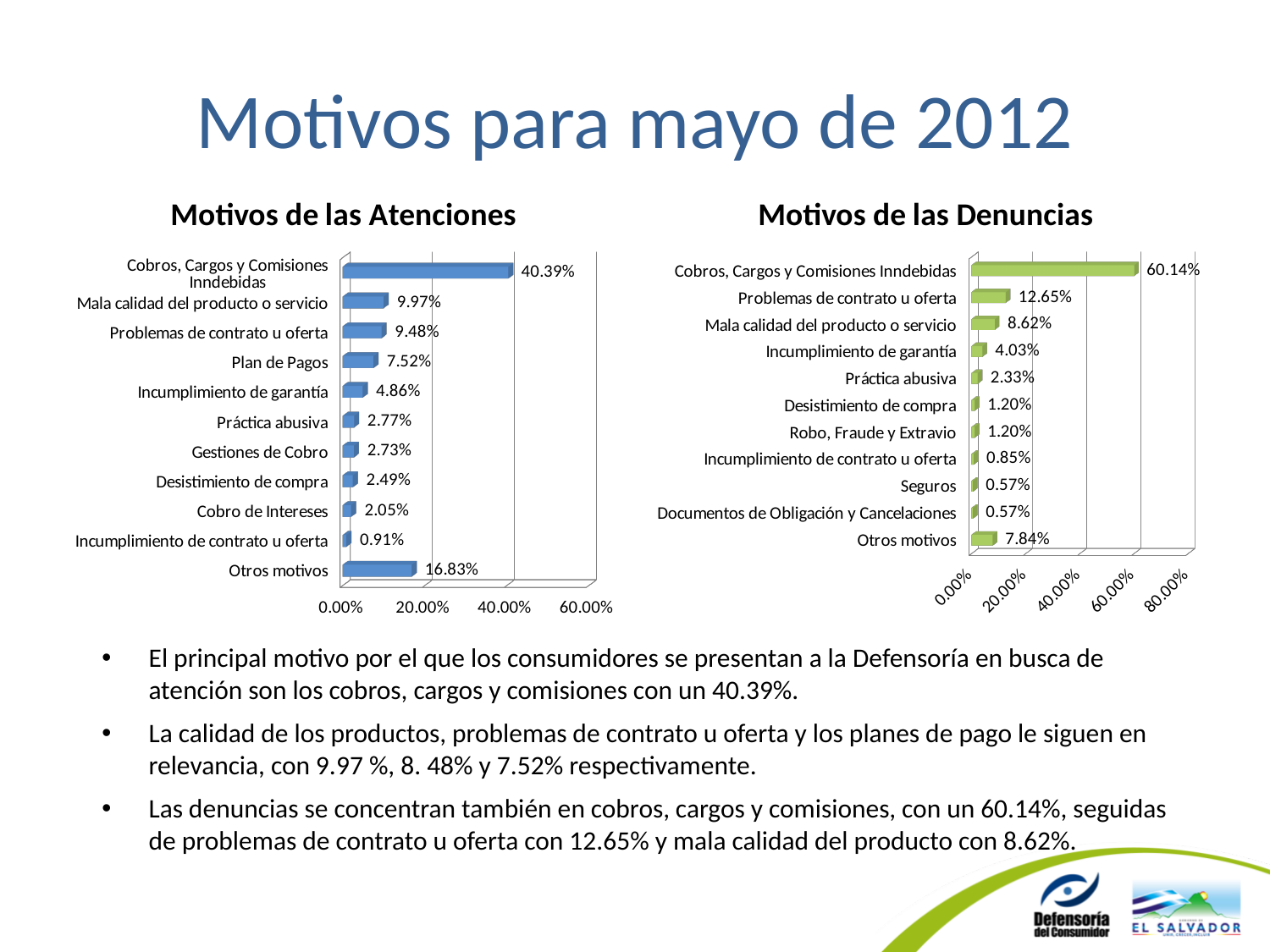
How many categories are shown in the 'Motivos de las Denuncias' chart? 11 In the 'Motivos de las Denuncias' chart, what is the value for Problemas de contrato u oferta? 12.65% In the 'Motivos de las Atenciones' chart, what is the difference between Mala calidad del producto o servicio and Problemas de contrato u oferta? 0.49% In the 'Motivos de las Denuncias' chart, which is larger: Incumplimiento de garantía or Otros motivos? Otros motivos What type of chart is 'Motivos de las Denuncias'? Bar chart In the 'Motivos de las Atenciones' chart, what is the value for Otros motivos? 16.83% In the 'Motivos de las Atenciones' chart, which category has the lowest value? Incumplimiento de contrato u oferta In the 'Motivos de las Denuncias' chart, which category has the highest value? Cobros, Cargos y Comisiones Inndebidas How many categories are shown in the 'Motivos de las Atenciones' chart? 11 In the 'Motivos de las Atenciones' chart, what is the value for Cobros, Cargos y Comisiones Inndebidas? 40.39% What colour are the bars in the 'Motivos de las Atenciones' chart? Blue In the 'Motivos de las Denuncias' chart, what is the difference between Cobros, Cargos y Comisiones Inndebidas and Problemas de contrato u oferta? 47.49%